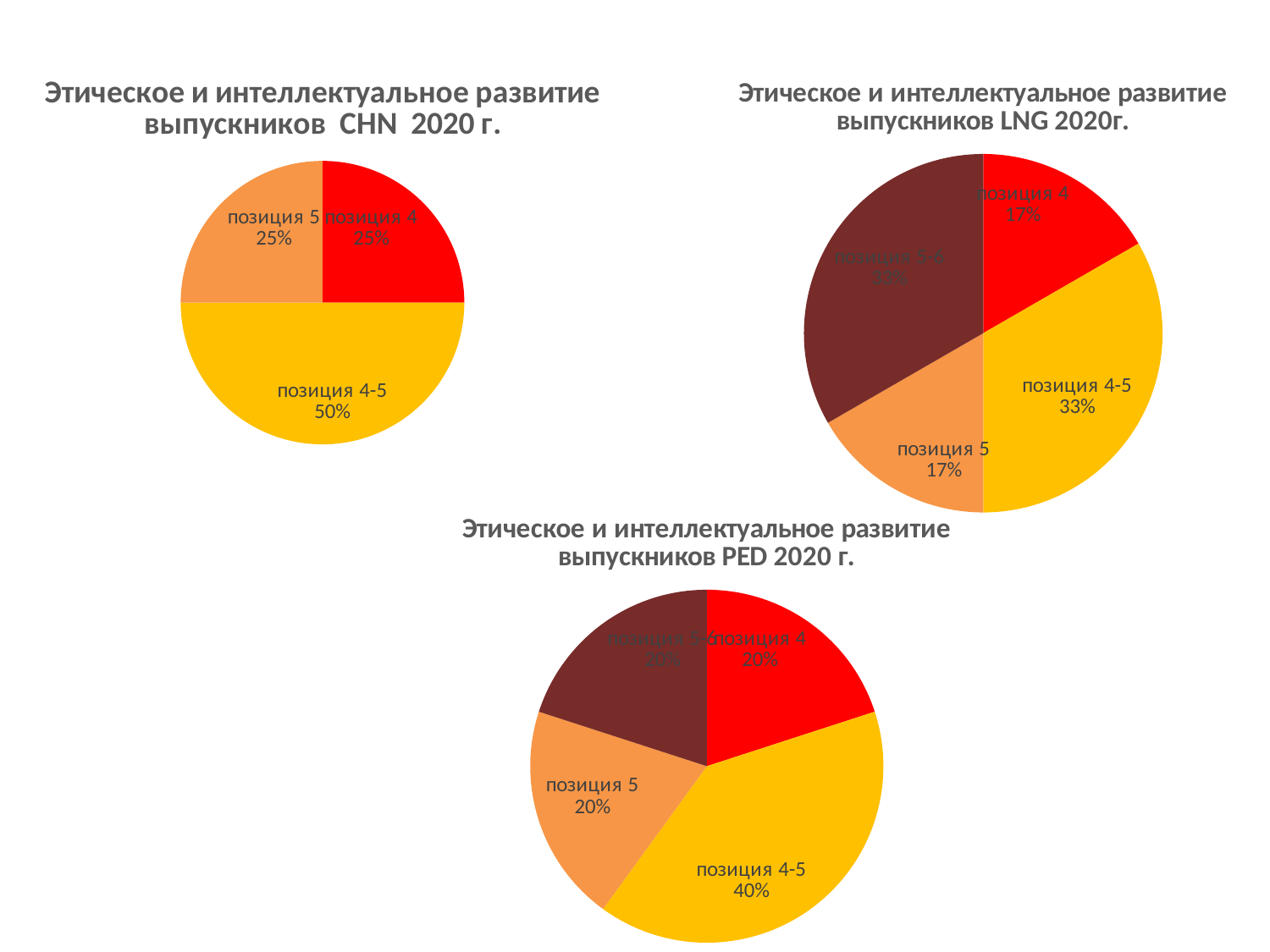
In the LNG 2020 chart, what share does позиция 4-5 have? 33% How many slices does the LNG 2020 pie chart have? 4 In the PED 2020 chart, what share does позиция 4-5 have? 40% What type of chart is used on this slide? pie chart In the LNG 2020 chart, what is the difference between the shares of позиция 4-5 and позиция 5? 16% In the PED 2020 chart, which category has the largest share? позиция 4-5 In the CHN 2020 chart, which category has the largest share? позиция 4-5 In the PED 2020 chart, is the share of позиция 4-5 larger or smaller than the share of позиция 5? larger In the CHN 2020 chart, what share does позиция 4-5 have? 50% In the CHN 2020 chart, what share does позиция 5 have? 25% In the LNG 2020 chart, what share does позиция 4 have? 17% How many slices does the CHN 2020 pie chart have? 3